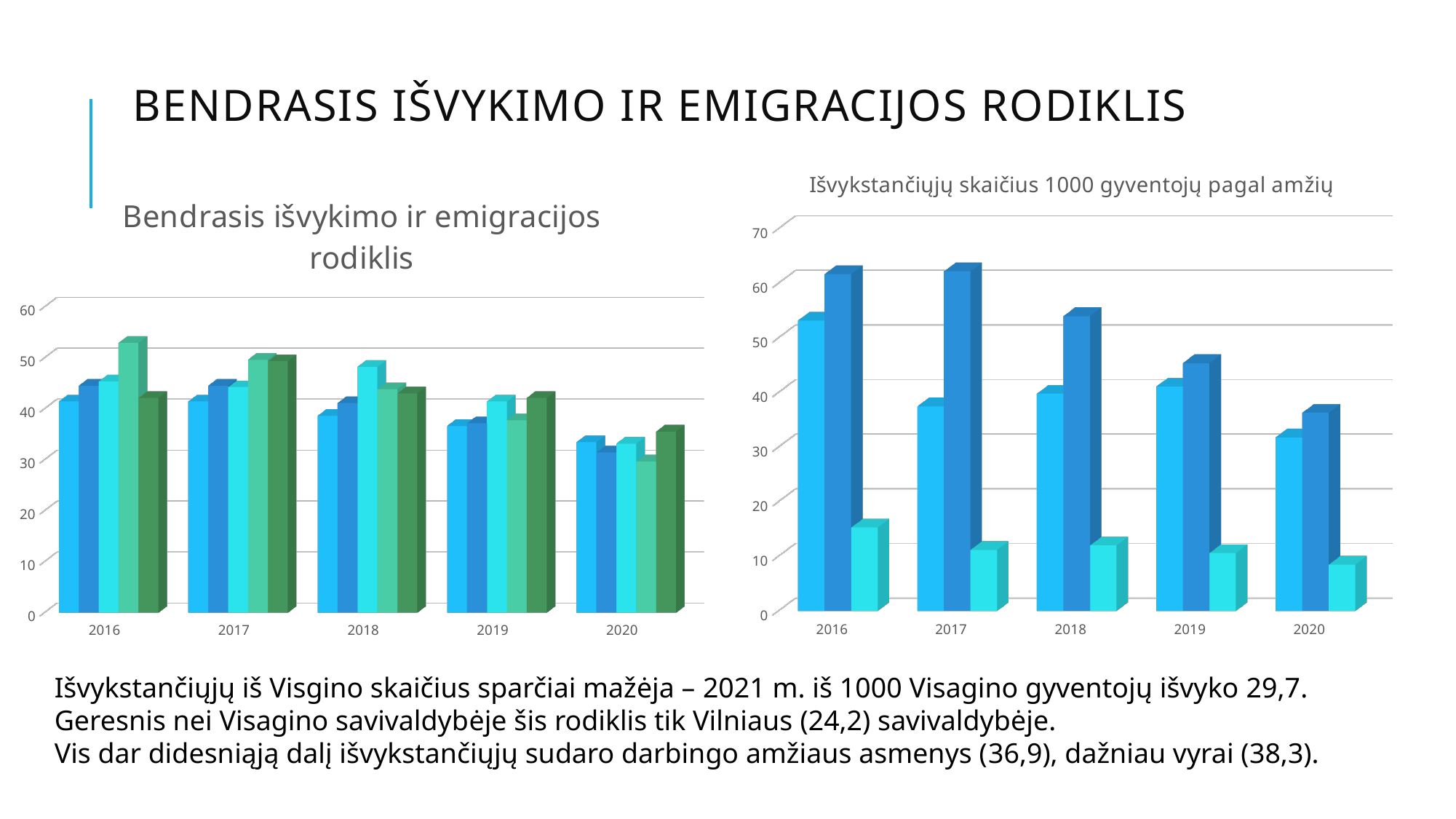
What is the title of the right chart on the slide? Išvykstančiųjų skaičius 1000 gyventojų pagal amžių How many years are shown on the x axis of the right chart "Išvykstančiųjų skaičius 1000 gyventojų pagal amžių"? 5 In the right chart "Išvykstančiųjų skaičius 1000 gyventojų pagal amžių", is the shortest bar for 2020 greater or less than 20? less In the right chart "Išvykstančiųjų skaičius 1000 gyventojų pagal amžių", for 2016, which is larger: the middle bar or the third (rightmost) bar? The middle bar What kind of chart is the left chart titled "Bendrasis išvykimo ir emigracijos rodiklis"? Bar chart In the left chart "Bendrasis išvykimo ir emigracijos rodiklis", are all the bars for 2020 greater or less than 40? less In the right chart "Išvykstančiųjų skaičius 1000 gyventojų pagal amžių", does the tallest bar in each year rise or fall from 2016 to 2020? fall In the right chart "Išvykstančiųjų skaičius 1000 gyventojų pagal amžių", is the tallest bar for 2016 greater or less than 50? greater In the left chart "Bendrasis išvykimo ir emigracijos rodiklis", do the values generally rise or fall from 2016 to 2020? fall How many years are shown on the x axis of the left chart "Bendrasis išvykimo ir emigracijos rodiklis"? 5 What is the title of the left chart on the slide? Bendrasis išvykimo ir emigracijos rodiklis